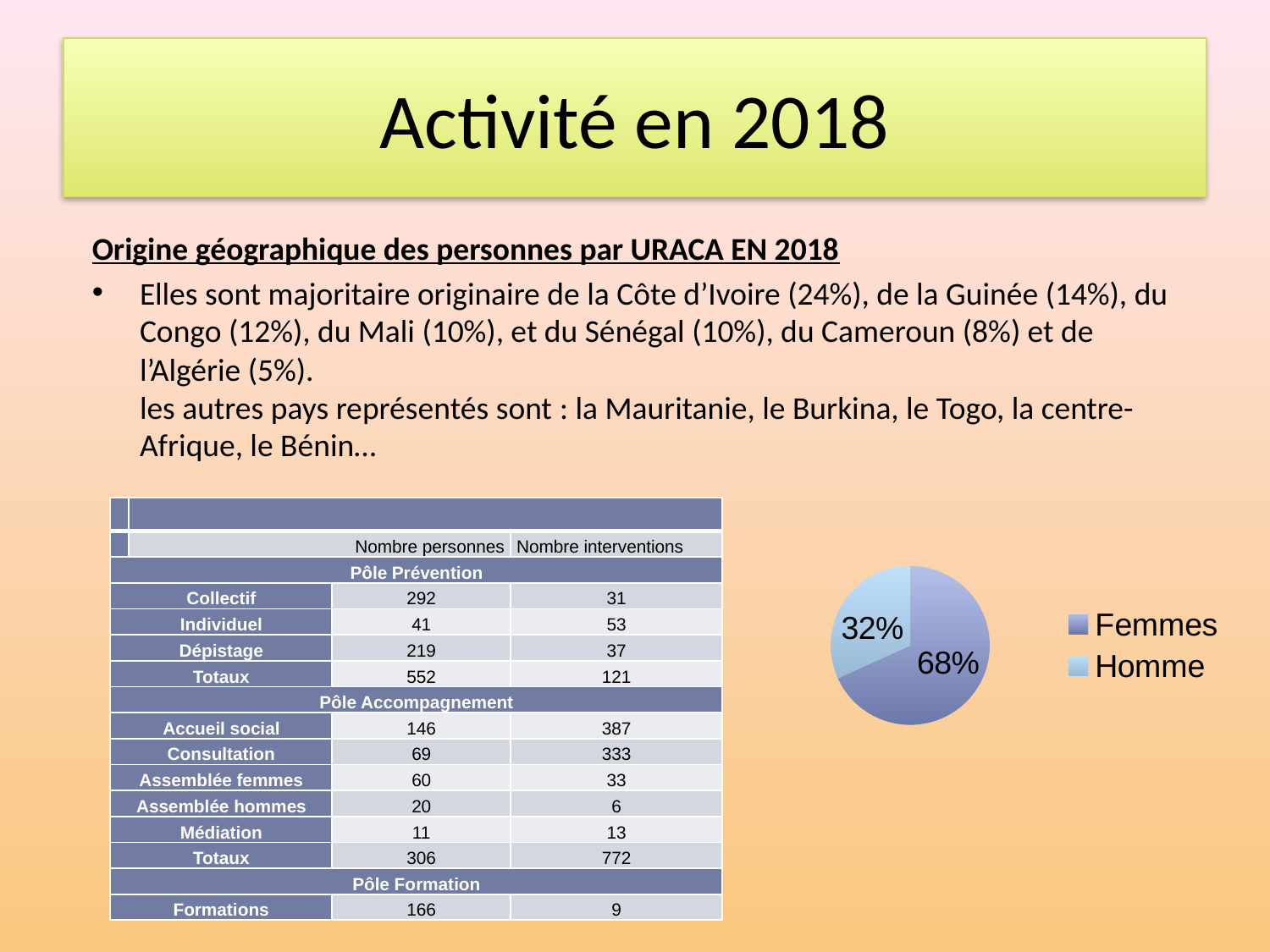
Which is larger in the pie chart, Femmes or Homme? Femmes What share of the pie chart is Homme? 32% What are the two legend entries of the pie chart? Femmes, Homme Which slice of the pie chart is the smallest? Homme How many slices does the pie chart have? 2 What share of the pie chart is Femmes? 68% What is the difference in percentage points between the Femmes and Homme slices? 36 How many entries does the pie chart legend list? 2 Which slice of the pie chart is the largest? Femmes What kind of chart is shown on the slide? pie chart Which legend entry of the pie chart is shown in the lighter blue colour? Homme Is the Femmes share of the pie chart greater or less than 50%? greater